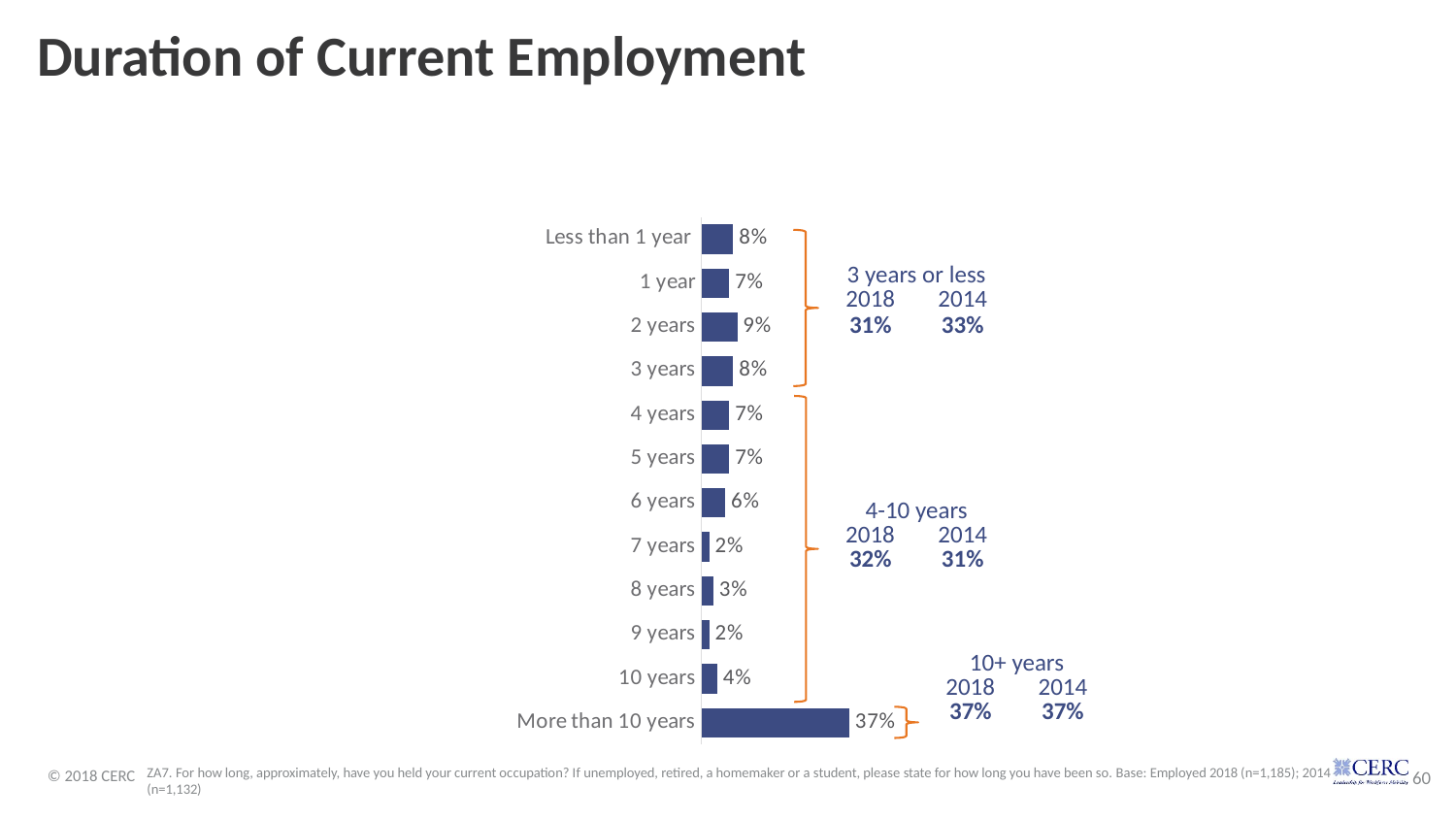
What is the 2014 combined value for the '4-10 years' group? 31% Which categories share the lowest value in the chart? 7 years and 9 years What is the difference between the values for 'More than 10 years' and '2 years'? 28% What is the value shown for 'More than 10 years'? 37% What is the value shown for the '2 years' category? 9% Which category has the highest value in the chart? More than 10 years What kind of chart is shown on the slide? Bar chart How many categories are plotted in the chart? 12 What percentage of respondents have been in their current employment for less than 1 year? 8% What is the 2018 combined value for the '3 years or less' group? 31% What is the title of the chart on the slide? Duration of Current Employment Which is larger, the value for '6 years' or the value for '8 years'? 6 years